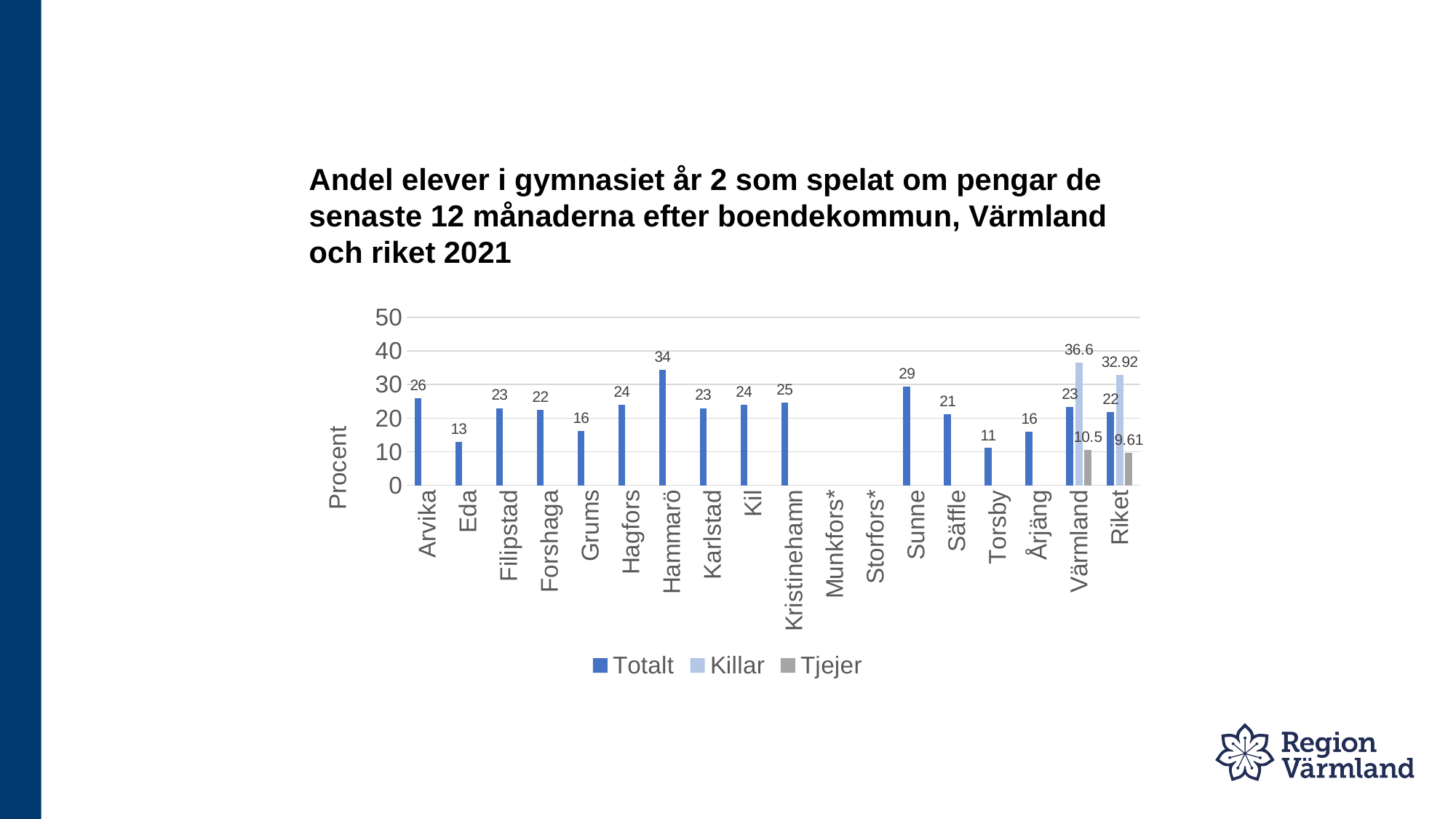
Is the Totalt value for Hammarö greater or less than 30? greater Which municipality has the lowest Totalt value among those with a bar shown? Torsby What is the difference between the Totalt values for Sunne and Eda? 16 Which municipality has the highest Totalt value? Hammarö How many series does the legend list? 3 Which has a larger Totalt value, Arvika or Säffle? Arvika What is the Killar value for Värmland? 36.6 What kind of chart is shown on the slide? Bar chart How many categories are shown on the x axis? 18 What is the Totalt value for Hammarö? 34 What is the label of the y axis? Procent What is the Tjejer value for Riket? 9.61